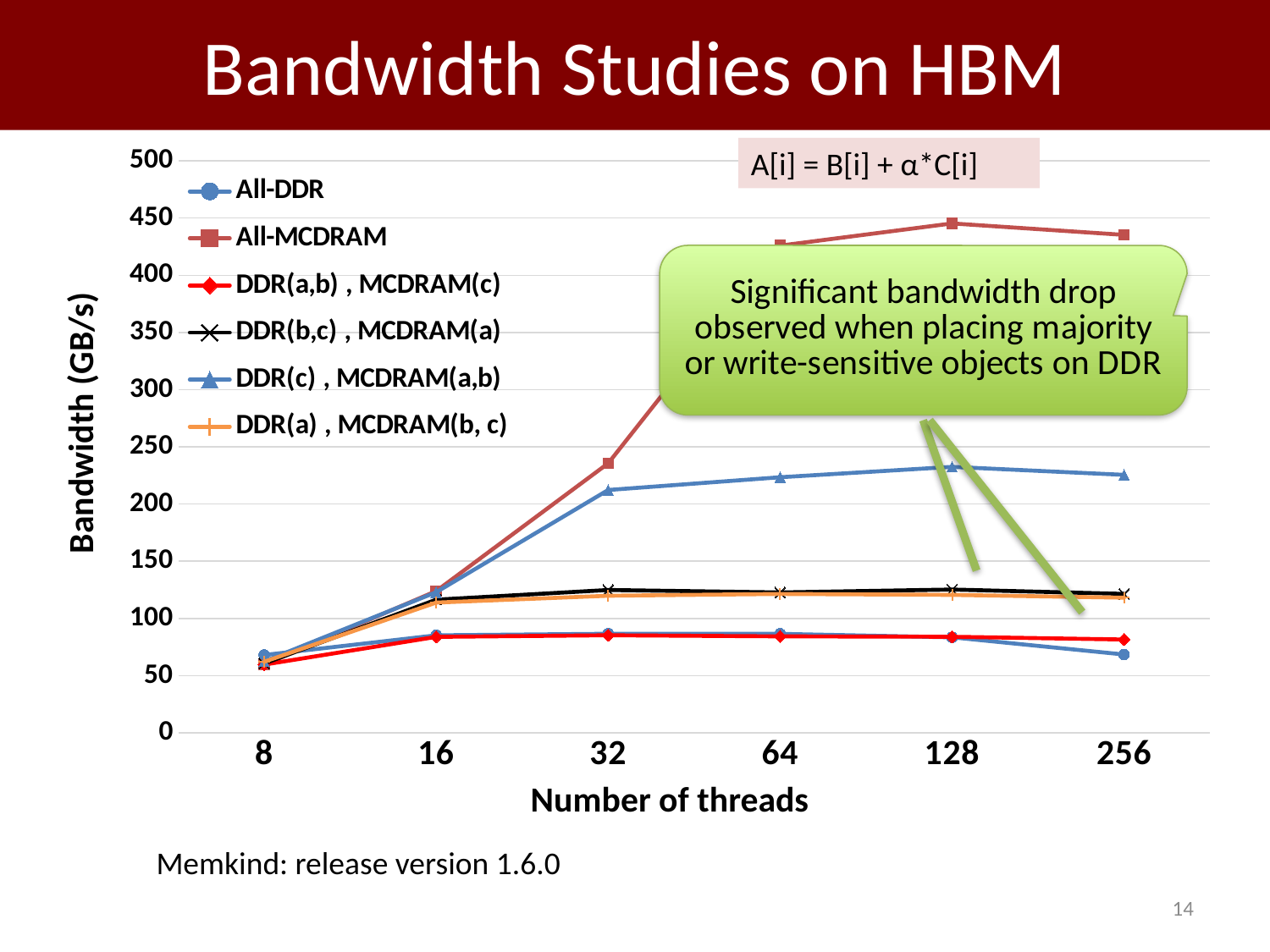
Which series has the highest bandwidth at 256 threads? All-MCDRAM How many series does the legend list? 6 What kind of chart is shown on the slide? line chart Is the value for All-DDR at 256 threads greater or less than 100? less Is the value for All-MCDRAM at 128 threads greater or less than 400? greater At 32 threads, which is larger: All-MCDRAM or DDR(c) , MCDRAM(a,b)? All-MCDRAM Which series has the lowest bandwidth at 256 threads? All-DDR Does the All-DDR series rise or fall from 128 to 256 threads? fall How many thread counts are plotted along the x axis? 6 Does the All-MCDRAM series rise or fall from 8 to 128 threads? rise What is the title of the y axis? Bandwidth (GB/s) Is the value for DDR(c) , MCDRAM(a,b) at 64 threads greater or less than 250? less